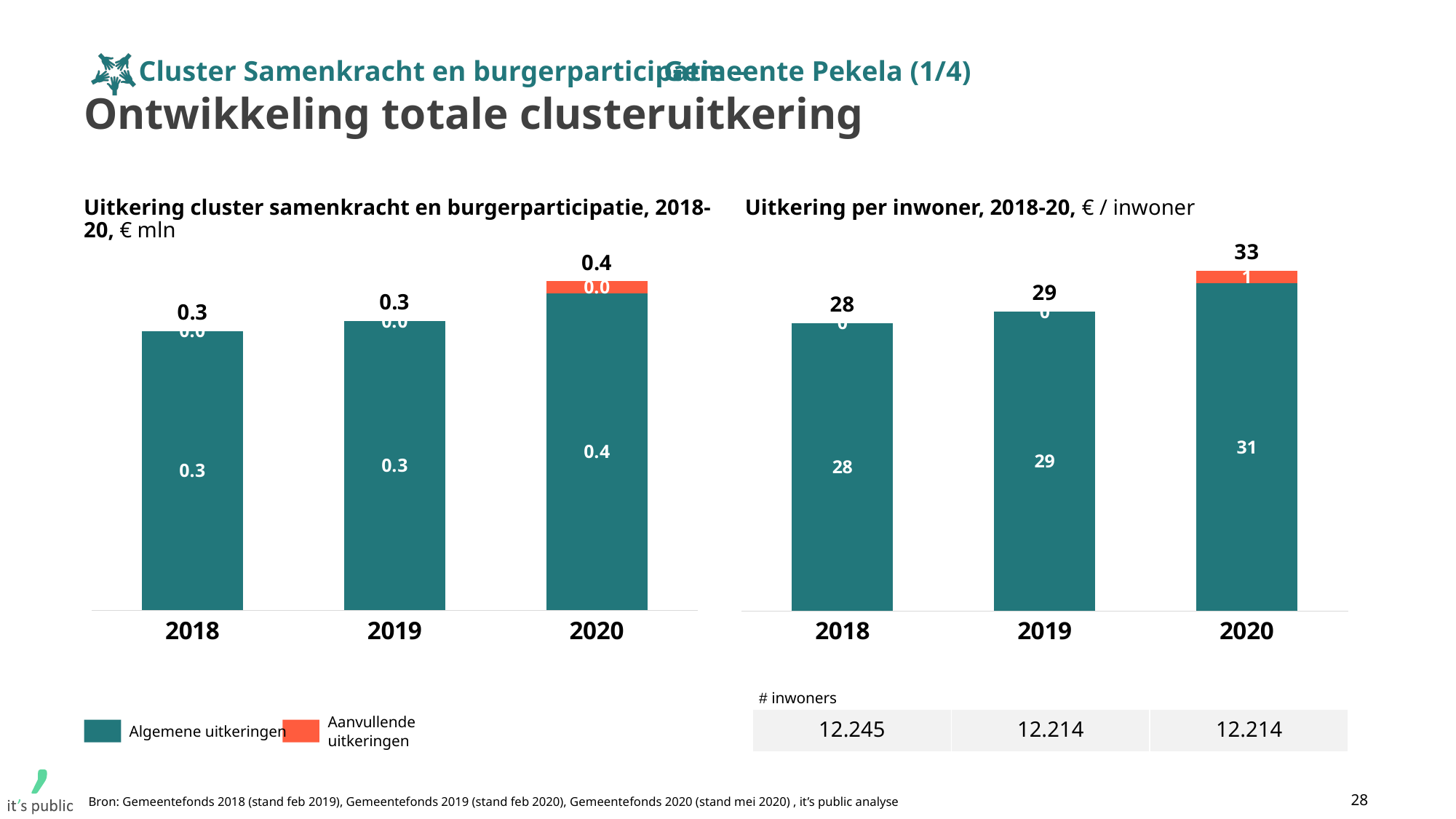
In the 'Uitkering per inwoner' chart, what is the value of Algemene uitkeringen for 2019? 29 In the 'Uitkering per inwoner' chart, what is the value of Aanvullende uitkeringen for 2020? 1 In the 'Uitkering per inwoner' chart, is the Algemene uitkeringen value for 2020 larger or smaller than for 2019? larger How many years are shown on the x axis of the 'Uitkering cluster samenkracht en burgerparticipatie' chart? 3 In the 'Uitkering per inwoner' chart, what is the difference between the total for 2020 and the total for 2018? 5 How many series does the legend list for the charts on the slide? 2 In the 'Uitkering cluster samenkracht en burgerparticipatie' chart, what is the value of Algemene uitkeringen for 2018? 0.3 In the 'Uitkering per inwoner' chart, which year has the lowest total? 2018 In the 'Uitkering per inwoner' chart, which year has the highest total? 2020 In the 'Uitkering per inwoner' chart, what is the total value for 2020? 33 What kind of chart is the 'Uitkering per inwoner' chart? Stacked bar chart In the 'Uitkering cluster samenkracht en burgerparticipatie' chart, what is the total value for 2020? 0.4